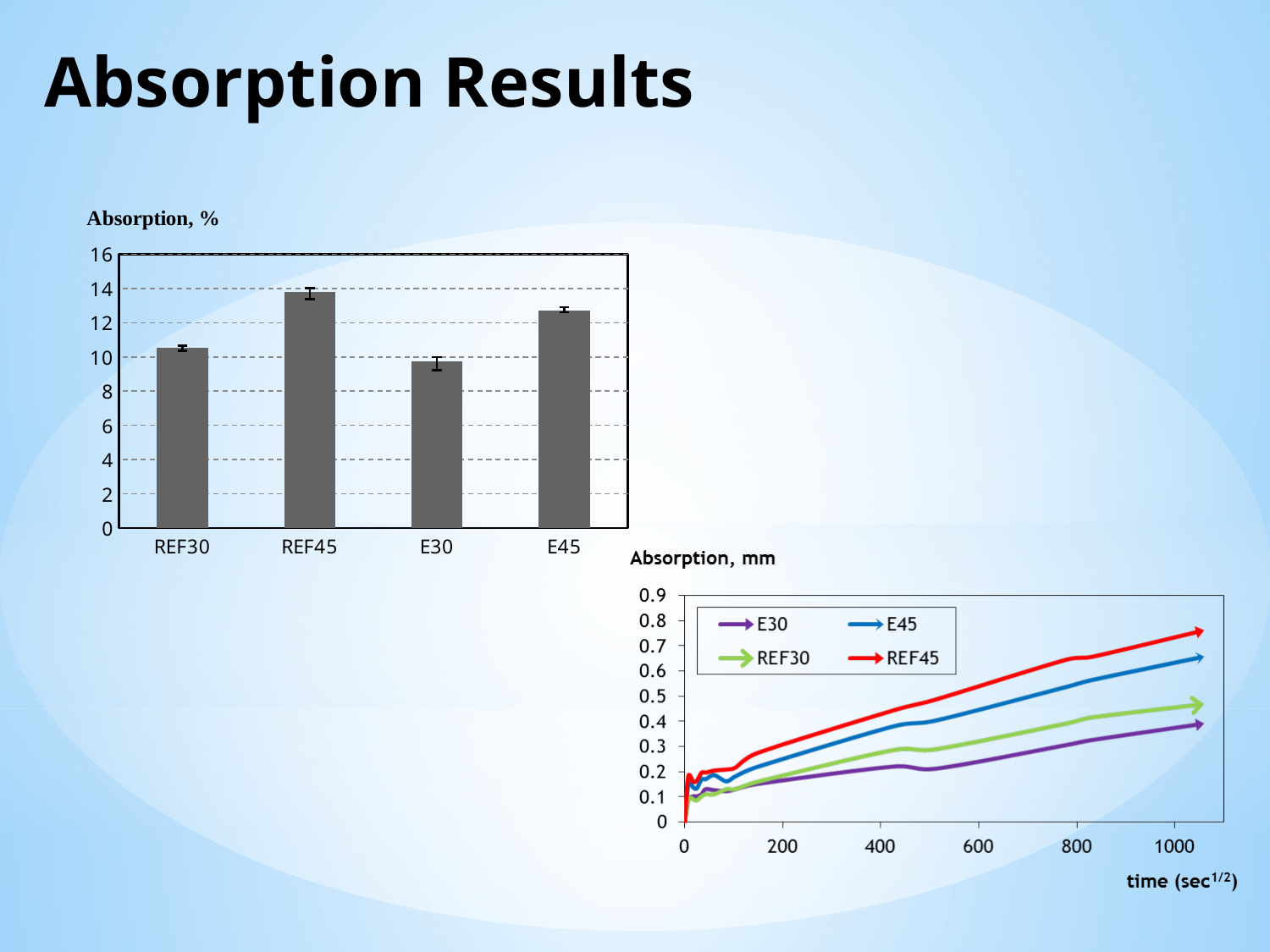
How many series does the legend of the 'Absorption, mm' line chart list? 4 In the 'Absorption, mm' line chart, which series has the highest absorption at the end of the time axis? REF45 In the 'Absorption, mm' line chart, do the values of the E45 series rise or fall as time increases? rise In the 'Absorption, %' bar chart, is the value for REF30 greater or less than 8? greater How many categories are shown on the x axis of the 'Absorption, %' bar chart? 4 In the 'Absorption, %' bar chart, is the value for E45 greater or less than 12? greater What kind of chart is the 'Absorption, %' chart on the left of the slide? bar chart What is the x-axis label of the 'Absorption, mm' line chart? time (sec^1/2) In the 'Absorption, %' bar chart, which category has the highest absorption? REF45 In the 'Absorption, %' bar chart, is the value for E30 greater or less than 12? less In the 'Absorption, %' bar chart, which is larger, the value for REF45 or the value for E45? REF45 In the 'Absorption, %' bar chart, which category has the lowest absorption? E30